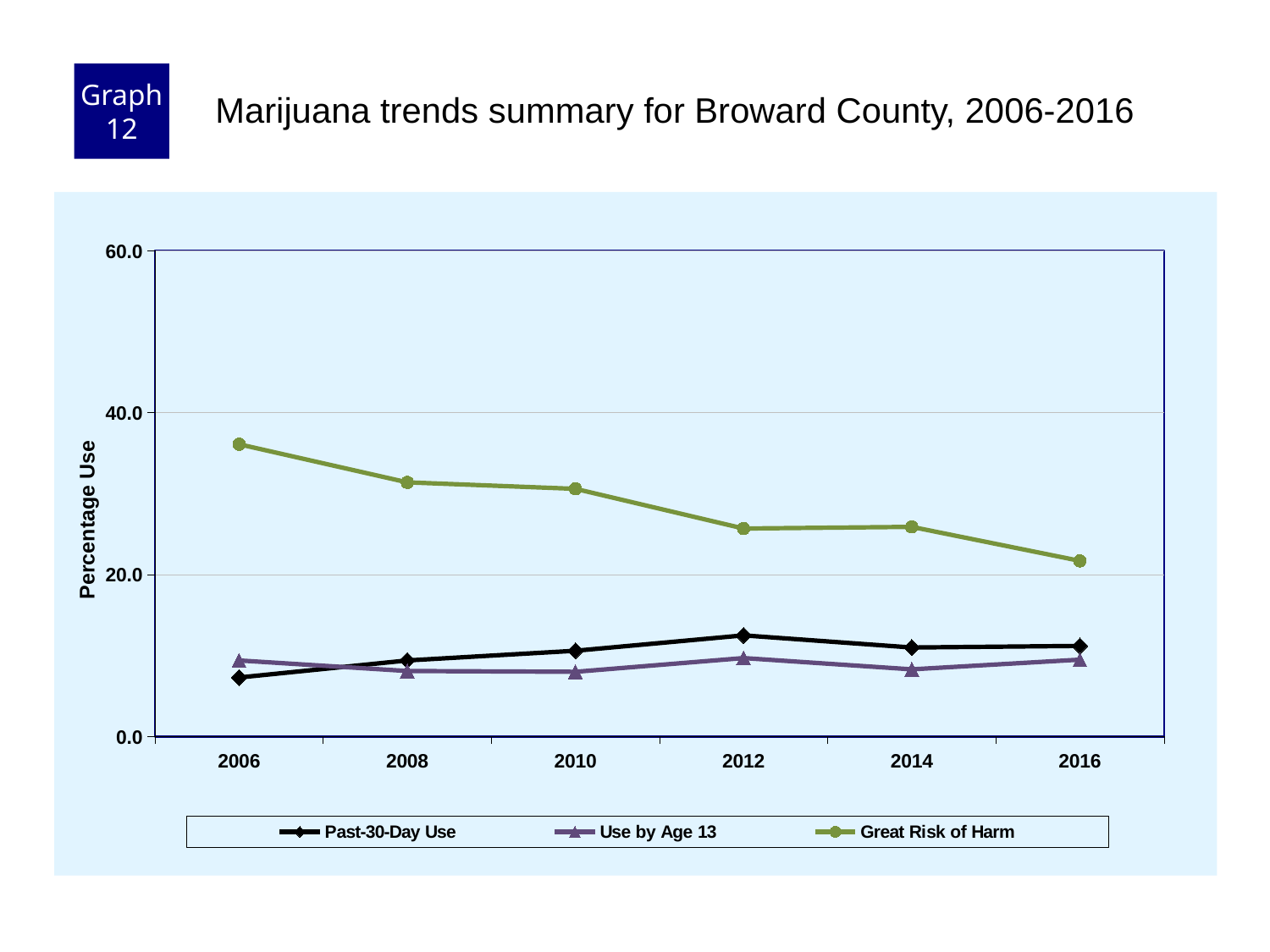
How many series does the legend list? 3 In which year is the Great Risk of Harm series at its lowest? 2016 Does the Great Risk of Harm series generally rise or fall from 2006 to 2016? Fall In which year is the Great Risk of Harm series at its highest? 2006 What is the label on the vertical axis? Percentage Use Is the value for Past-30-Day Use in 2012 greater or less than 20.0? less How many years are plotted along the x axis? 6 In 2006, which is larger: Past-30-Day Use or Use by Age 13? Use by Age 13 Is the value for Great Risk of Harm in 2006 greater or less than 20.0? greater In which year is the Past-30-Day Use series at its lowest? 2006 In which year does the Past-30-Day Use series reach its highest value? 2012 What kind of chart is shown on the slide? Line chart